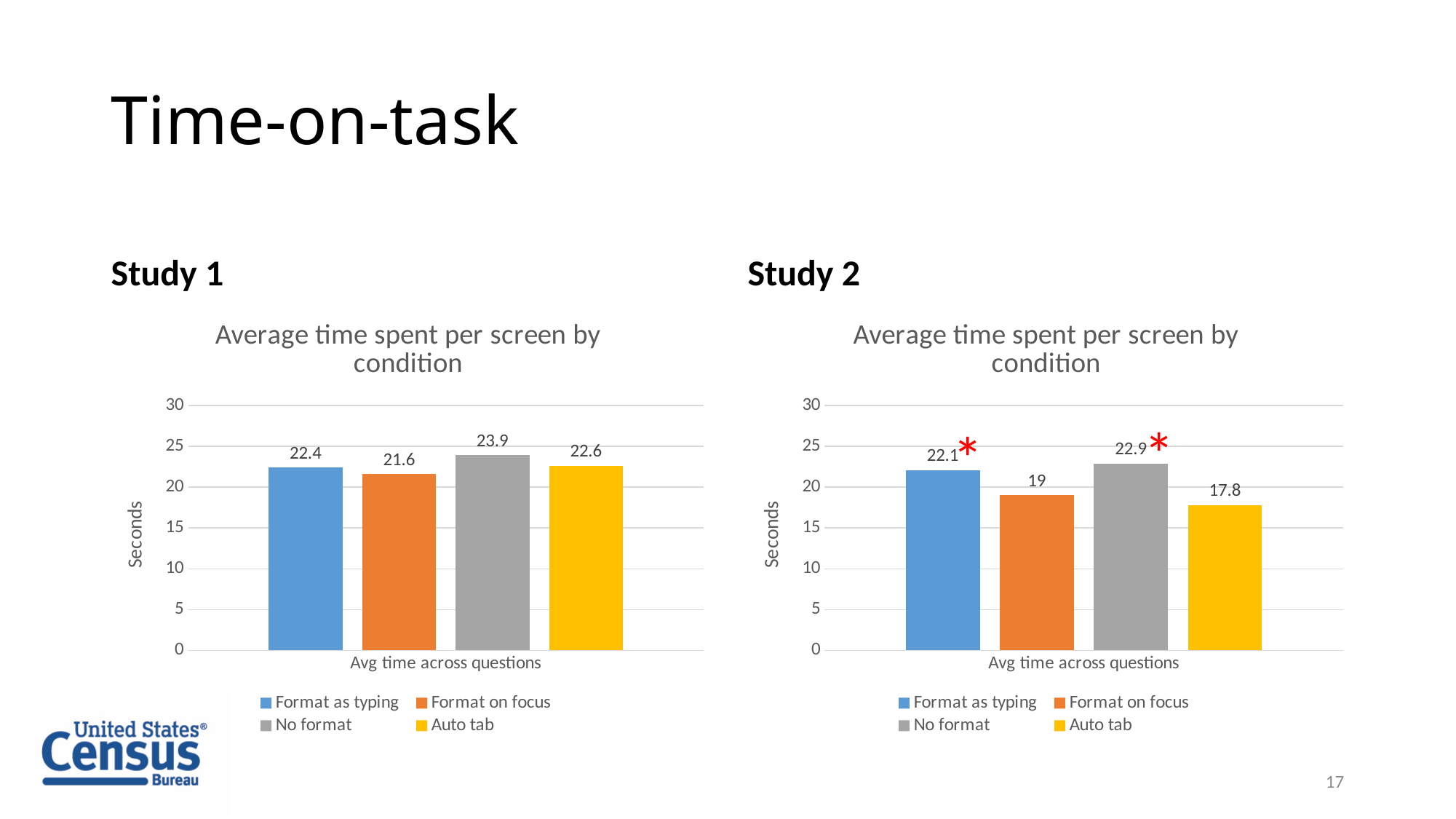
In the Study 2 chart, what is the difference between No format and Auto tab? 5.1 What type of chart is the Study 2 chart? Bar chart In the Study 1 chart, which series has the lowest value? Format on focus In the Study 2 chart, which series has the highest value? No format In the Study 1 chart, which series has the highest value? No format In the Study 1 chart, what is the value for Format as typing? 22.4 In the Study 2 chart, what is the value for Auto tab? 17.8 In the Study 2 chart, what is the value for Format on focus? 19 How many series does the legend of the Study 1 chart list? 4 In the Study 2 chart, which series has the lowest value? Auto tab In the Study 2 chart, which is larger, Format as typing or Format on focus? Format as typing In the Study 1 chart, what is the difference between No format and Format on focus? 2.3